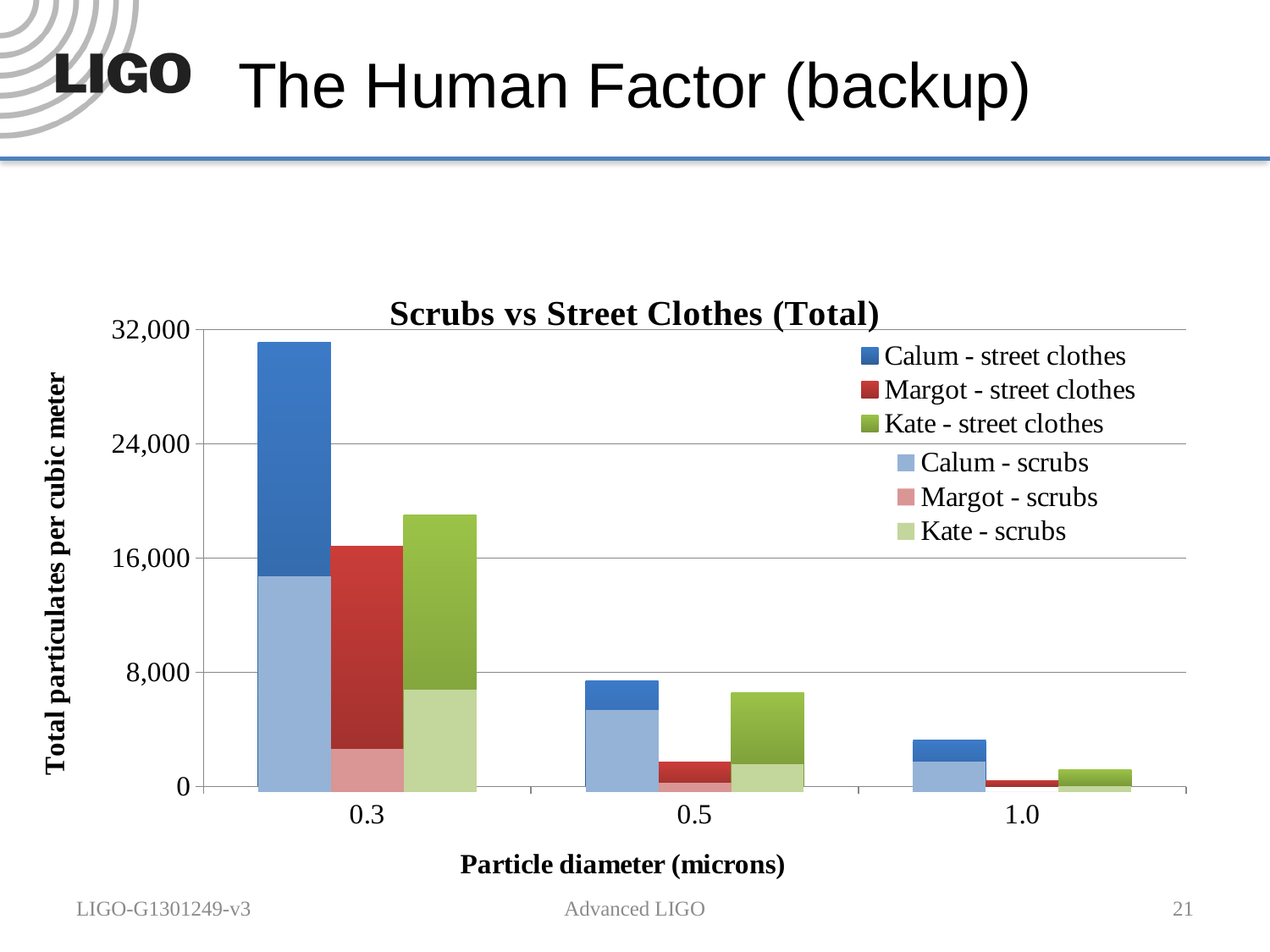
How many particle diameter categories are shown on the x axis? 3 At 0.5 microns, whose total bar is taller, Calum's or Kate's? Calum What kind of chart is shown on the slide? Bar chart Which person has the tallest bar at the 0.3 micron particle diameter? Calum How many series does the chart legend list? 6 Do the total particulate values rise or fall as particle diameter increases along the x axis? fall Is the total bar for Calum at 0.3 microns greater or less than 24,000? greater Is the total bar for Margot at 0.3 microns greater or less than 16,000? greater Which person has the shortest bar at the 0.3 micron particle diameter? Margot Is the total bar for Calum at 0.5 microns greater or less than 8,000? less At 1.0 microns, whose total bar is taller, Kate's or Margot's? Kate What is the title of the chart? Scrubs vs Street Clothes (Total)